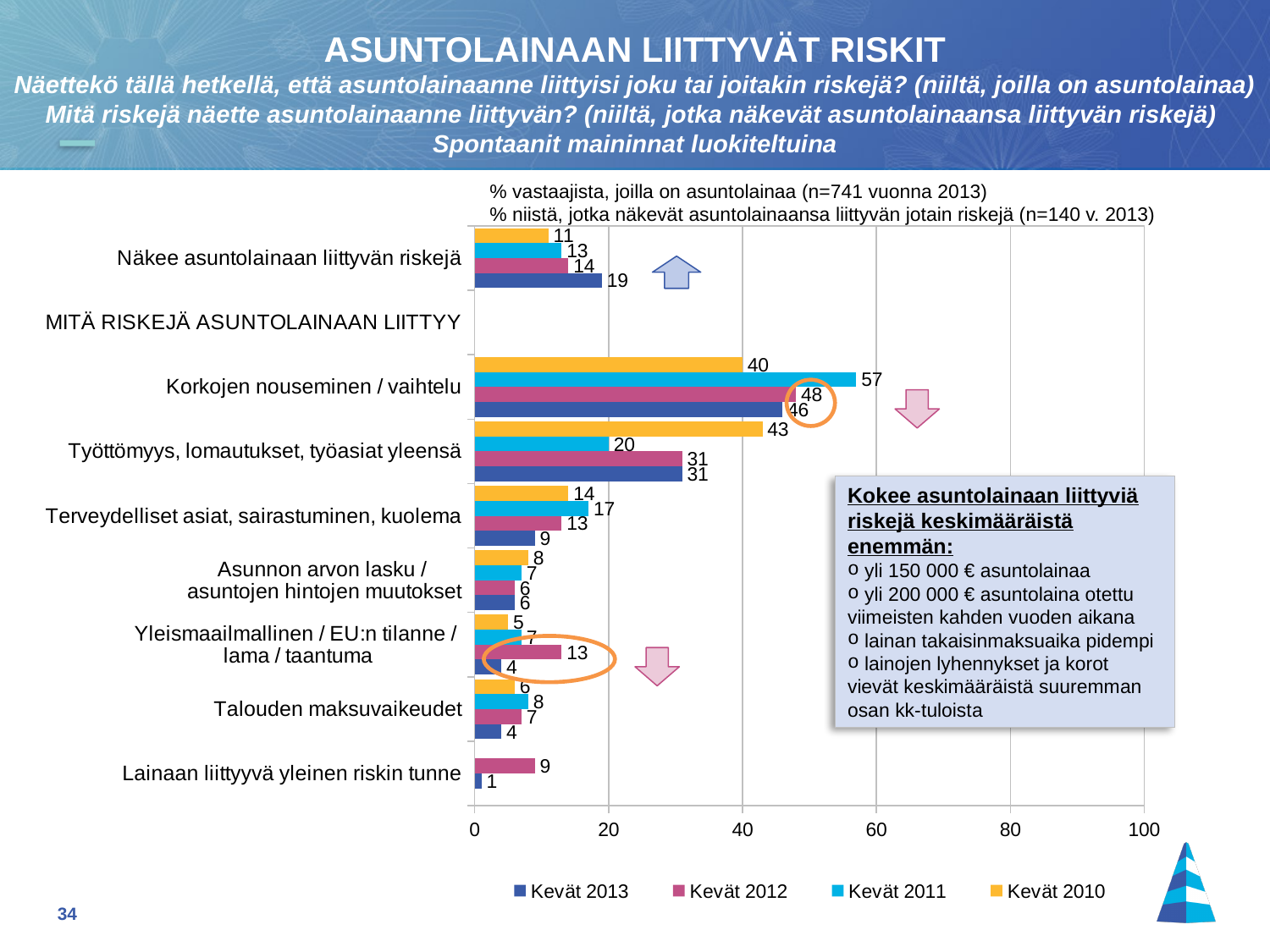
By how much did the value for "Näkee asuntolainaan liittyvän riskejä" increase from Kevät 2010 to Kevät 2013? 8 Which risk category has the highest Kevät 2013 value? Korkojen nouseminen / vaihtelu For "Työttömyys, lomautukset, työasiat yleensä", which is larger: the Kevät 2010 value or the Kevät 2011 value? Kevät 2010 What is the Kevät 2013 value for "Näkee asuntolainaan liittyvän riskejä"? 19 What kind of chart is shown on the slide? Bar chart How many series does the legend list? 4 What is the Kevät 2013 value for "Korkojen nouseminen / vaihtelu"? 46 What is the Kevät 2012 value for "Yleismaailmallinen / EU:n tilanne / lama / taantuma"? 13 What is the Kevät 2011 value for "Korkojen nouseminen / vaihtelu"? 57 Is the Kevät 2010 value for "Työttömyys, lomautukset, työasiat yleensä" greater or less than 40? greater What is the difference between the Kevät 2011 and Kevät 2013 values for "Korkojen nouseminen / vaihtelu"? 11